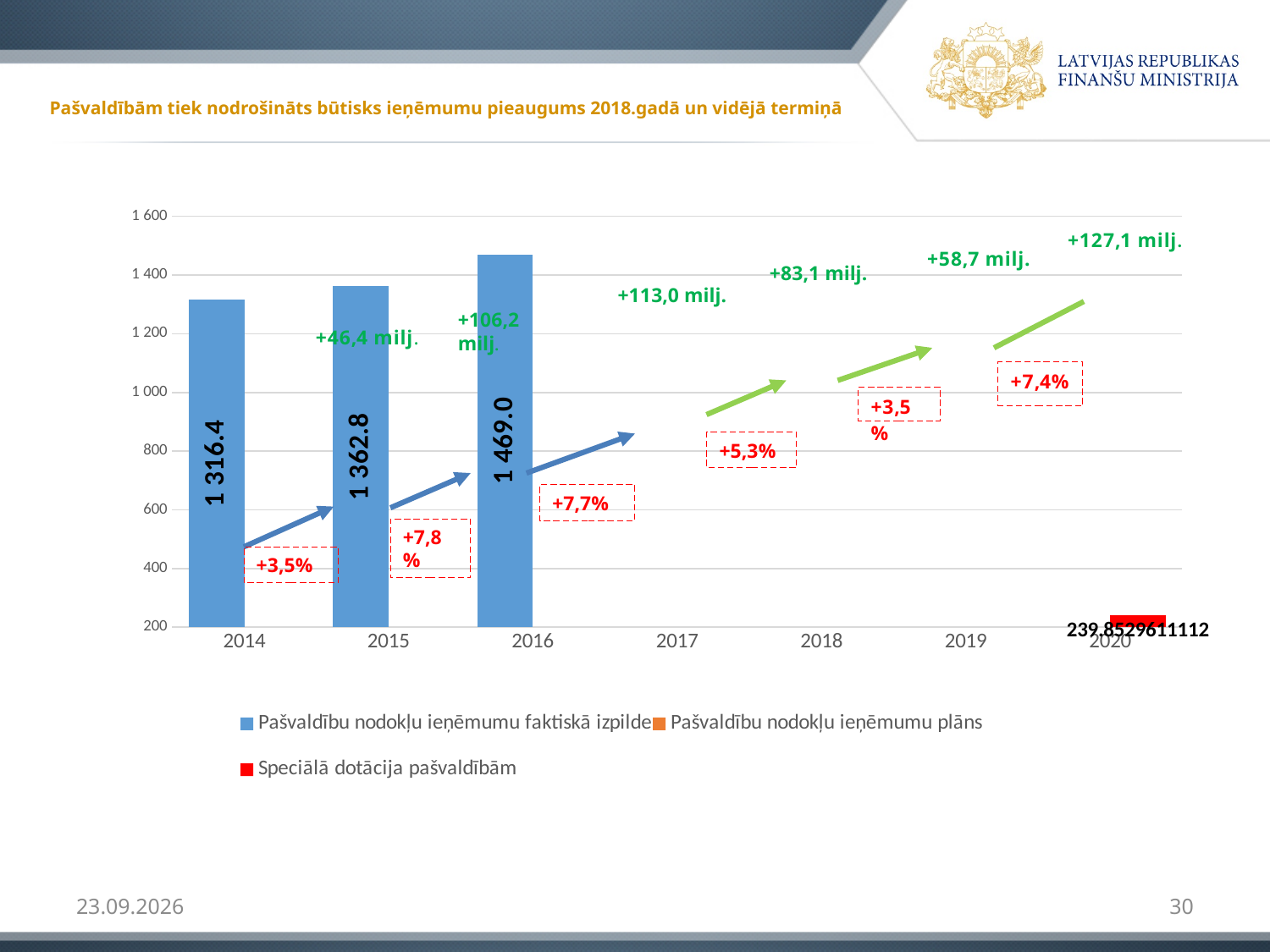
Which is larger, the blue bar for 2015 or the blue bar for 2014? 2015 Which year has the lowest blue bar? 2014 What is the difference between the blue bar values for 2016 and 2015? 106.2 What kind of chart is shown on the slide? bar chart Which year has the highest blue bar? 2016 What is the value of the blue bar for 2015? 1 362.8 What is the value of the blue bar for 2016? 1 469.0 How many years are shown on the x axis? 7 What is the value of the blue bar for 2014? 1 316.4 Is the value of the blue bar for 2014 greater or less than 1 200? greater Do the blue bar values rise or fall from 2014 to 2016? rise How many series does the legend list? 3